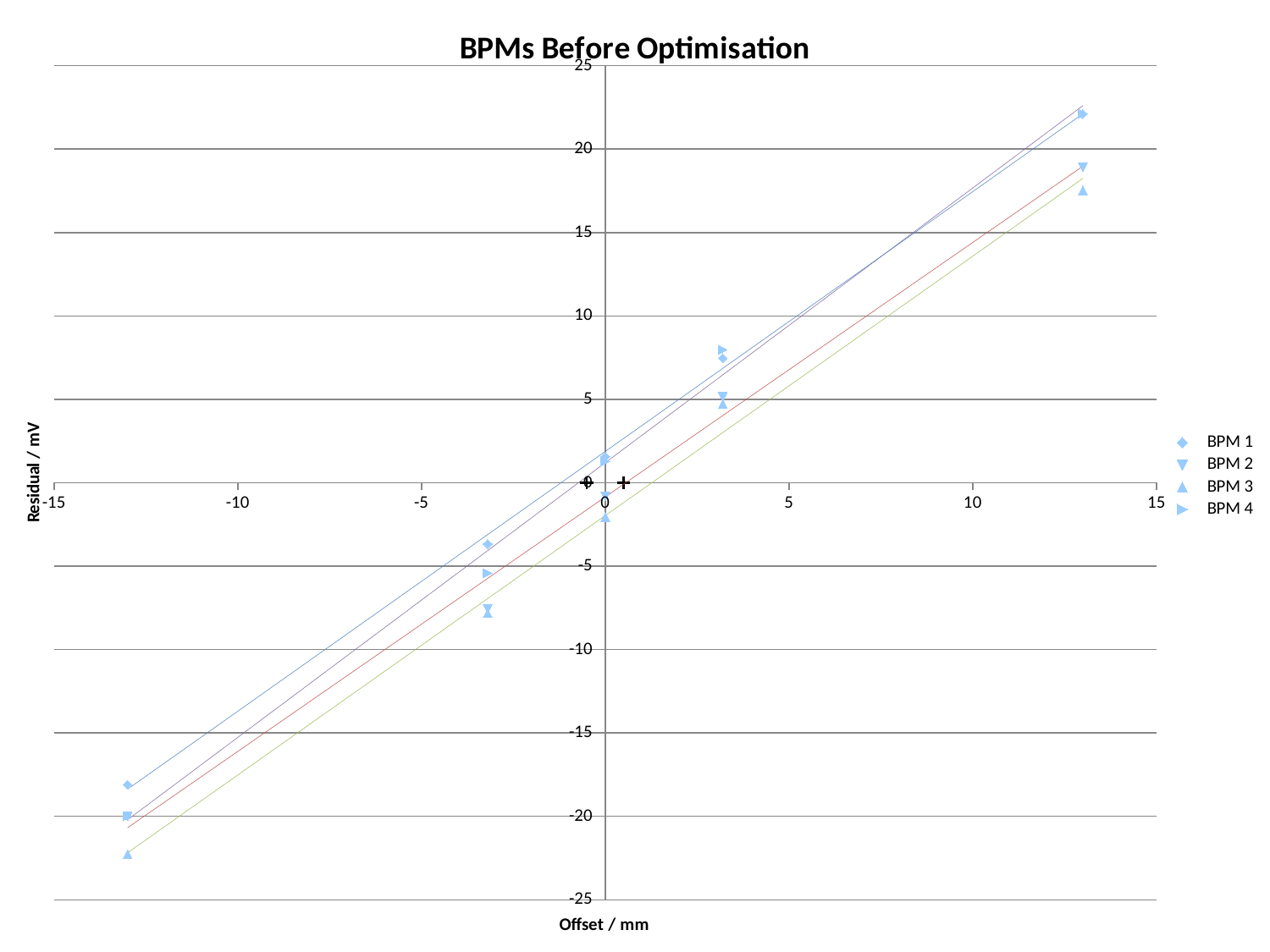
Is the value for BPM 1 at an offset of about 3 mm greater or less than 5? greater Is the value for BPM 3 at the rightmost offset (around 13 mm) greater or less than 20? less Do the residual values rise or fall as the offset increases along the x axis? rise At the rightmost offset (around 13 mm), which has the larger residual, BPM 1 or BPM 3? BPM 1 At the rightmost offset (around 13 mm), which series has the lowest residual? BPM 3 What is the title of the chart? BPMs Before Optimisation Is the value for BPM 1 at the rightmost offset (around 13 mm) greater or less than 20? greater What kind of chart is shown on the slide? scatter chart How many series does the legend list? 4 What is the label of the x axis? Offset / mm